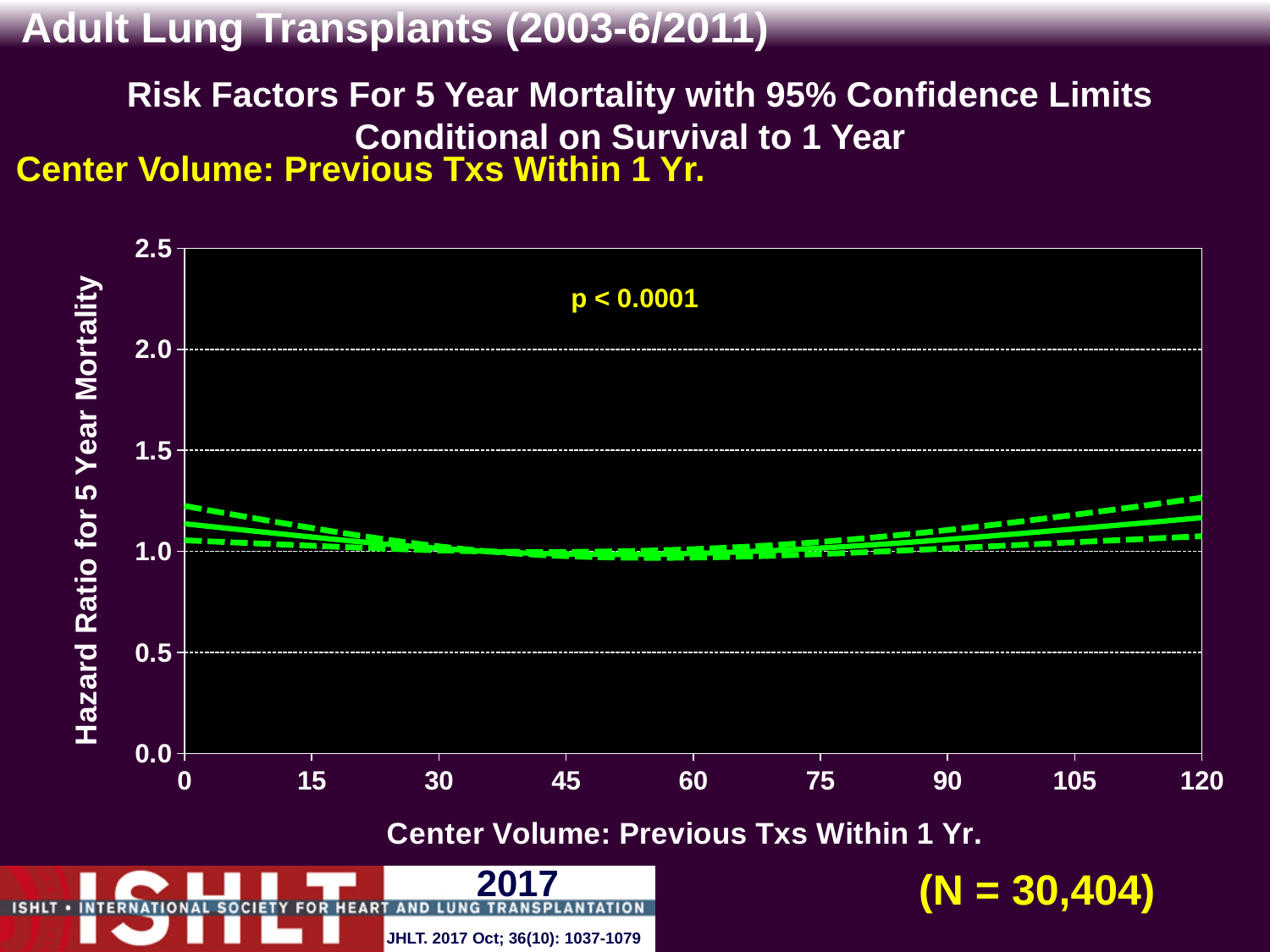
What kind of chart is shown on the slide? line chart What is the highest value shown on the x axis? 120 What p-value is printed on the chart? p < 0.0001 What is the title of the x axis? Center Volume: Previous Txs Within 1 Yr. Is the hazard ratio of the solid line at a center volume of 0 greater or less than 1.0? greater Is the hazard ratio of the solid line higher at a center volume of 120 or at 45? 120 Is the hazard ratio of the solid line at a center volume of 120 greater or less than 1.5? less What is the highest value shown on the y axis? 2.5 Does the solid hazard ratio line rise or fall between a center volume of 75 and 120? rise What is the title of the y axis? Hazard Ratio for 5 Year Mortality How many tick labels are shown on the x axis? 9 What sample size (N) is printed on the slide? N = 30,404